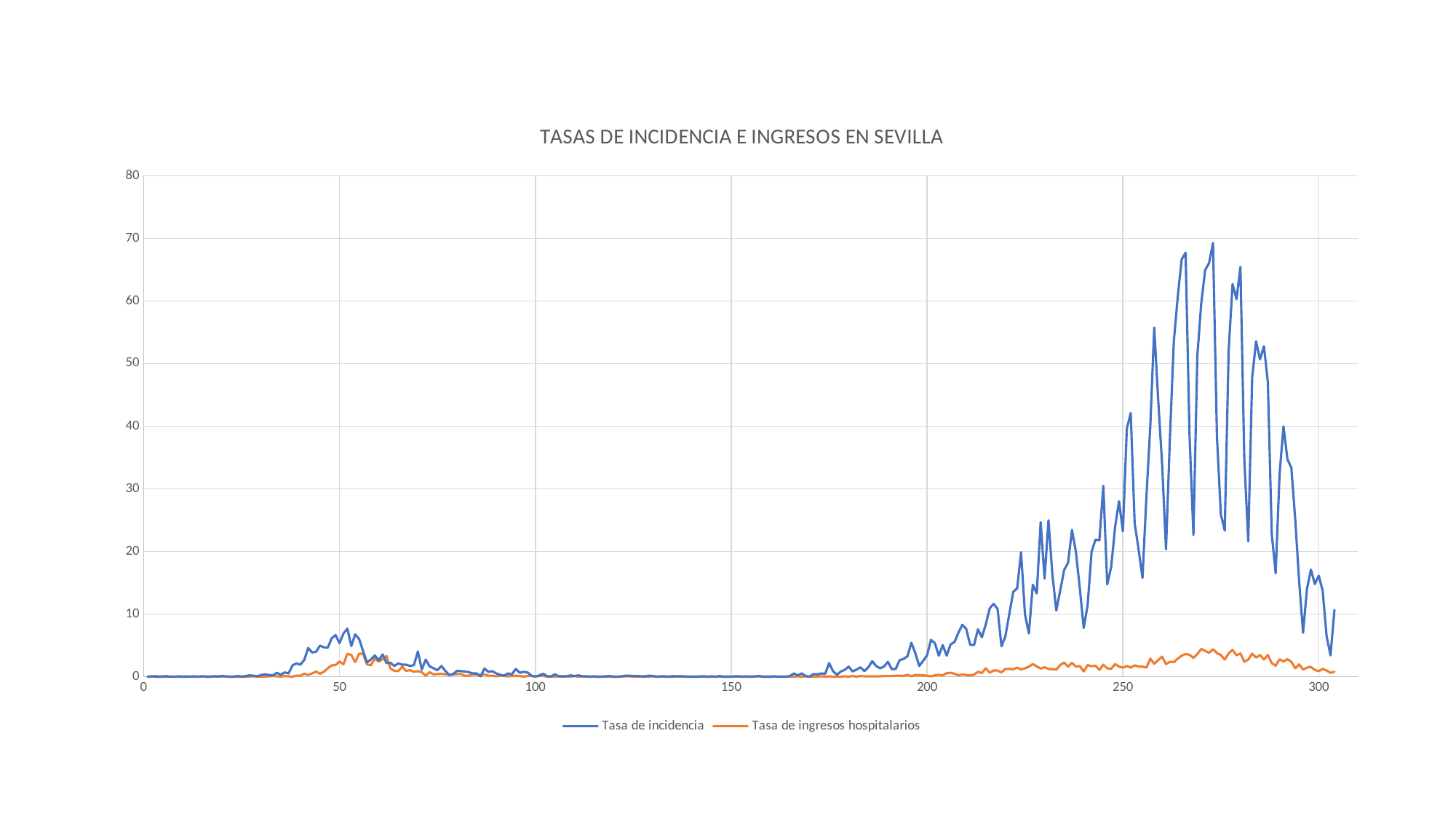
Which series is drawn in orange? Tasa de ingresos hospitalarios Is the highest value of Tasa de ingresos hospitalarios greater or less than 10? less Does Tasa de incidencia generally rise or fall between x = 200 and x = 270? rise Is the value of Tasa de incidencia at x = 100 greater or less than 10? less Does Tasa de incidencia generally rise or fall between x = 280 and x = 300? fall What kind of chart is shown on the slide? line chart Is the highest value of Tasa de incidencia greater or less than 60? greater How many series does the legend list? 2 Which series reaches the higher peak value, Tasa de incidencia or Tasa de ingresos hospitalarios? Tasa de incidencia What is the title of the chart? TASAS DE INCIDENCIA E INGRESOS EN SEVILLA